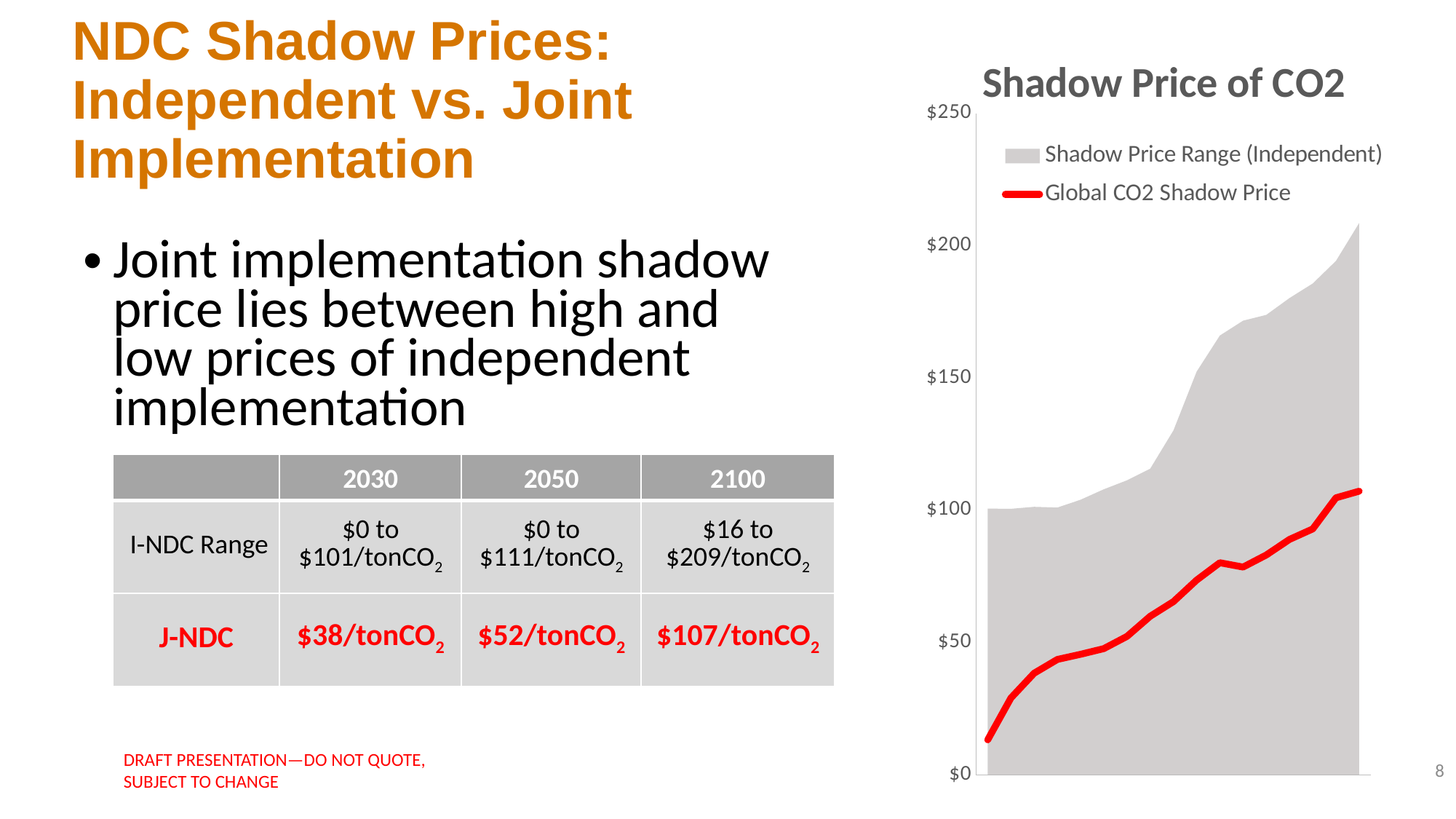
In the Shadow Price of CO2 chart, is the upper edge of the Shadow Price Range (Independent) at the right end greater or less than $200? greater In the Shadow Price of CO2 chart, is the Global CO2 Shadow Price at the right end of the line greater or less than $150? less In the Shadow Price of CO2 chart, is the Global CO2 Shadow Price at the right end of the line greater or less than $100? greater What is the title of the chart on the right of the slide? Shadow Price of CO2 How many series does the legend of the Shadow Price of CO2 chart list? 2 In the Shadow Price of CO2 chart, does the upper edge of the Shadow Price Range (Independent) area rise or fall from left to right? Rise What is the highest value shown on the vertical axis of the Shadow Price of CO2 chart? $250 What are the two legend entries in the Shadow Price of CO2 chart? Shadow Price Range (Independent) and Global CO2 Shadow Price In the Shadow Price of CO2 chart, does the Global CO2 Shadow Price line rise or fall from left to right? Rise What kind of chart is the Shadow Price of CO2 chart? Area chart with a line